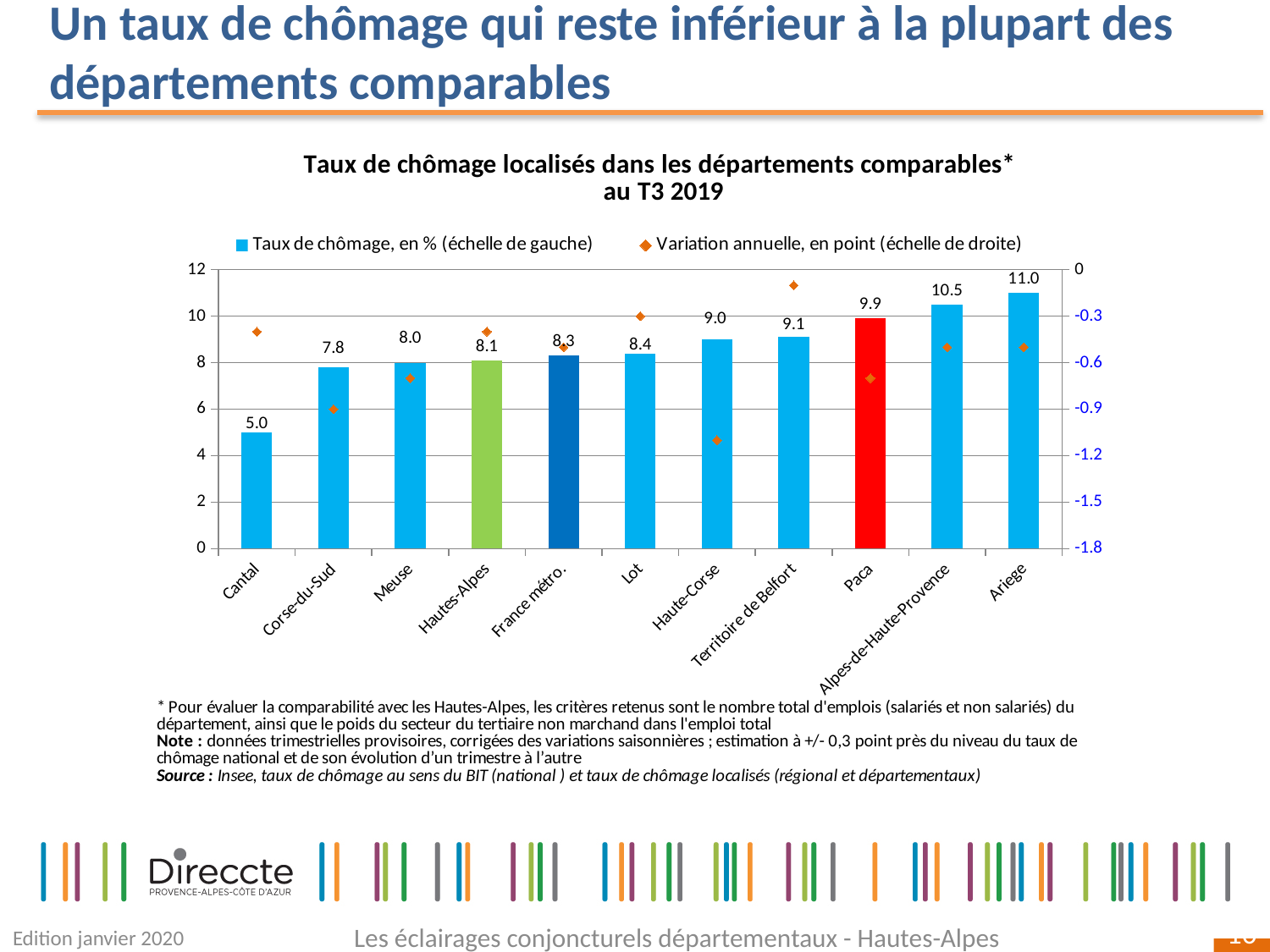
What is the unemployment rate (taux de chômage) shown for Hautes-Alpes? 8.1 Which department has the highest unemployment rate on the chart? Ariege What is the difference between the unemployment rate of Ariege and that of Hautes-Alpes? 2.9 Do the unemployment rate bars rise or fall from left to right along the x axis? rise Which has a higher unemployment rate, Alpes-de-Haute-Provence or Territoire de Belfort? Alpes-de-Haute-Provence How many departments or areas are shown on the x axis of the chart? 11 What is the unemployment rate shown for Paca? 9.9 Is the annual variation (variation annuelle) for Haute-Corse greater or less than -0.9? less What is the unemployment rate shown for Cantal? 5.0 Which department has the lowest unemployment rate on the chart? Cantal Is the annual variation (variation annuelle) for Territoire de Belfort greater or less than -0.3? greater How many series does the chart legend list? 2